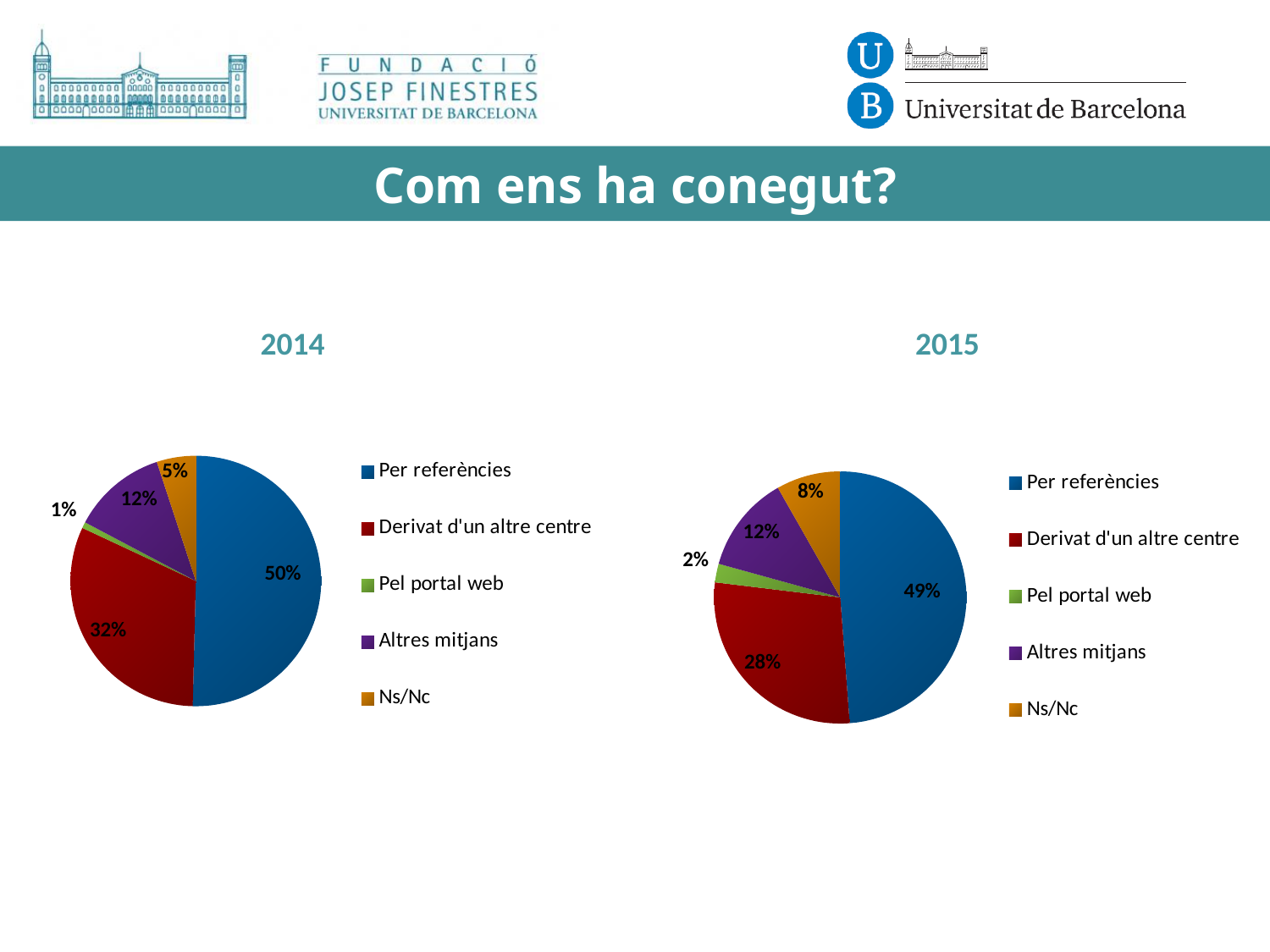
How many categories does the 2015 chart's legend list? 5 In the 2015 chart, what share does 'Derivat d'un altre centre' have? 28% In the 2015 chart, which category has the largest slice? Per referències In the 2014 chart, which category has the smallest slice? Pel portal web In the 2014 chart, what is the difference between the shares of 'Per referències' and 'Derivat d'un altre centre'? 18% What kind of chart is the 2014 chart? Pie chart In the 2015 chart, which is larger: 'Altres mitjans' or 'Ns/Nc'? Altres mitjans In the 2014 chart, what share does 'Pel portal web' have? 1% In the 2015 chart, what share does 'Ns/Nc' have? 8% In the 2014 chart, what colour is the 'Ns/Nc' slice? Orange What is the title of the 2015 chart? 2015 In the 2014 chart, what share does 'Per referències' have? 50%